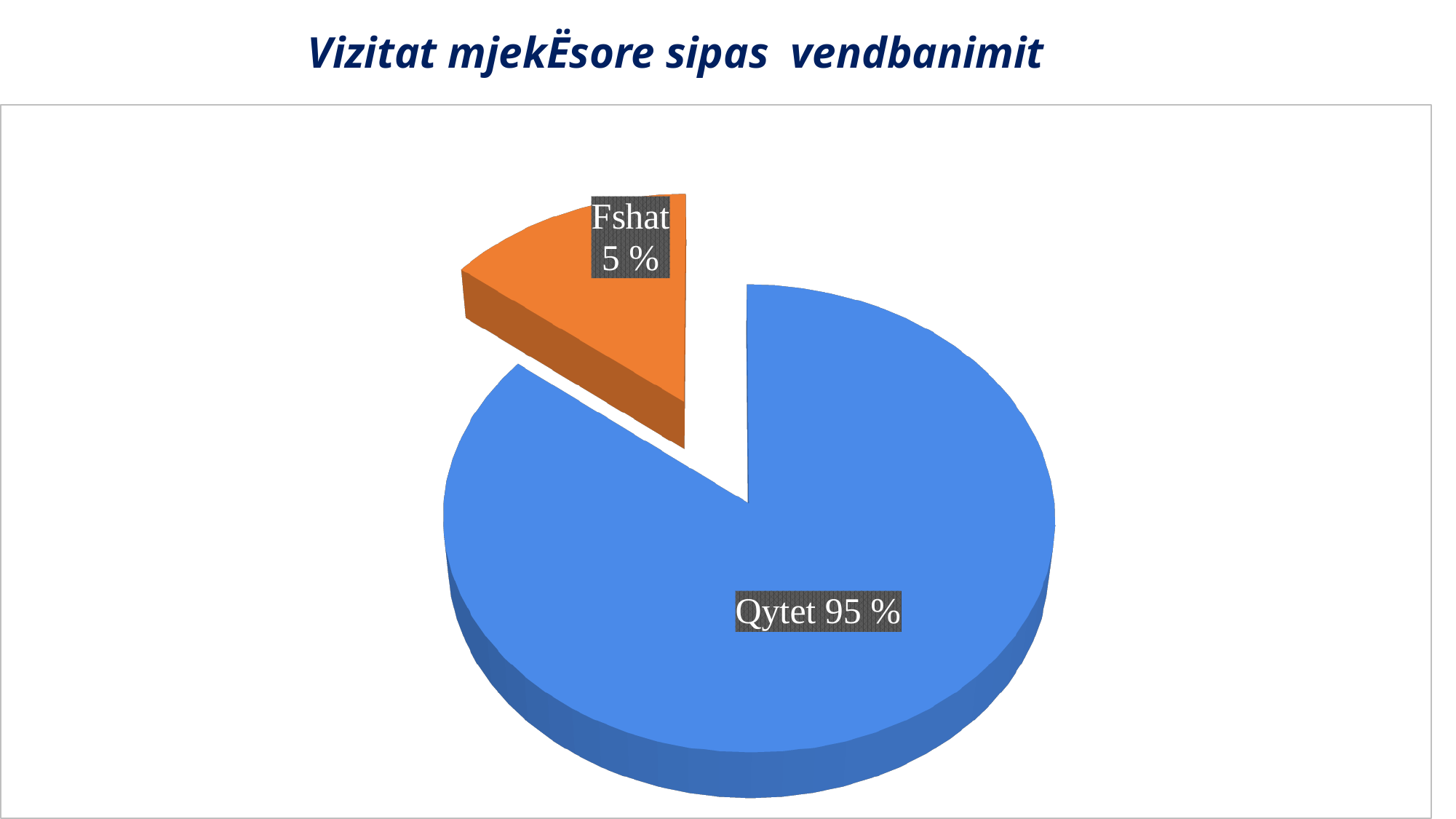
What is the difference in percentage points between the Qytet and Fshat slices? 90 What share of the pie does Qytet have? 95 % What share of the pie does Fshat have? 5 % What is the title of the chart? Vizitat mjekËsore sipas vendbanimit What kind of chart is shown on the slide? pie chart What colour is the Fshat slice? orange Which category has the smallest slice of the pie? Fshat How many slices does the pie chart have? 2 Which category has the largest slice of the pie? Qytet Which slice is larger, Qytet or Fshat? Qytet